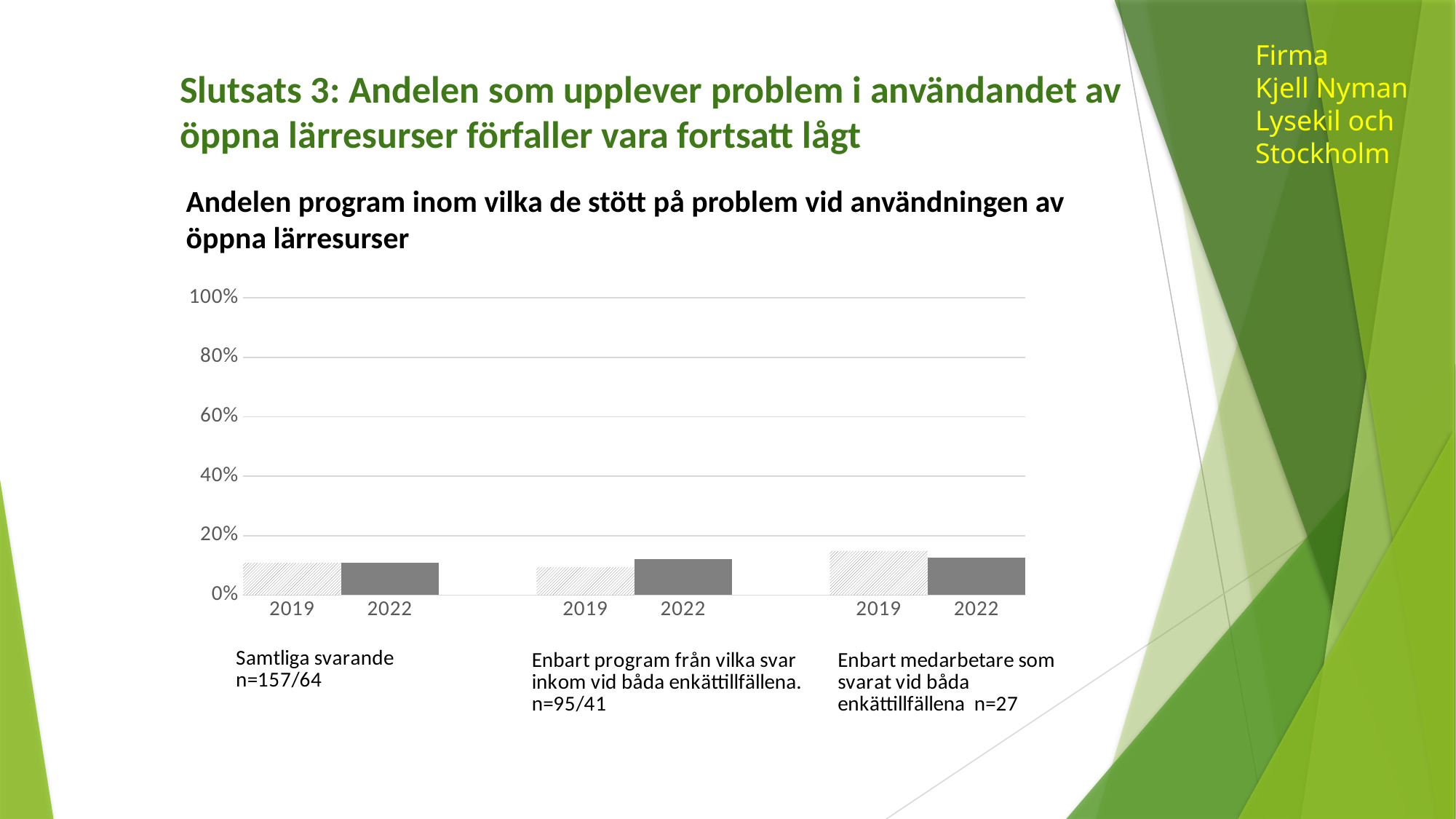
Is the 2022 value for 'Enbart program från vilka svar inkom vid båda enkättillfällena' greater or less than 40%? less What sample size is given for the 'Samtliga svarande' group? n=157/64 Is the 2019 value for 'Enbart medarbetare som svarat vid båda enkättillfällena' greater or less than 20%? less How many respondent groups are shown along the x axis of the chart? 3 What is the title of the chart? Andelen program inom vilka de stött på problem vid användningen av öppna lärresurser For 'Enbart program från vilka svar inkom vid båda enkättillfällena', which year has the larger value, 2019 or 2022? 2022 Is the 2019 value for 'Samtliga svarande' greater or less than 20%? less What kind of chart is shown on the slide? bar chart What is the highest value shown on the chart's vertical axis? 100% How many bars are plotted in the chart? 6 Which 2019 bar is taller: 'Samtliga svarande' or 'Enbart medarbetare som svarat vid båda enkättillfällena'? Enbart medarbetare som svarat vid båda enkättillfällena